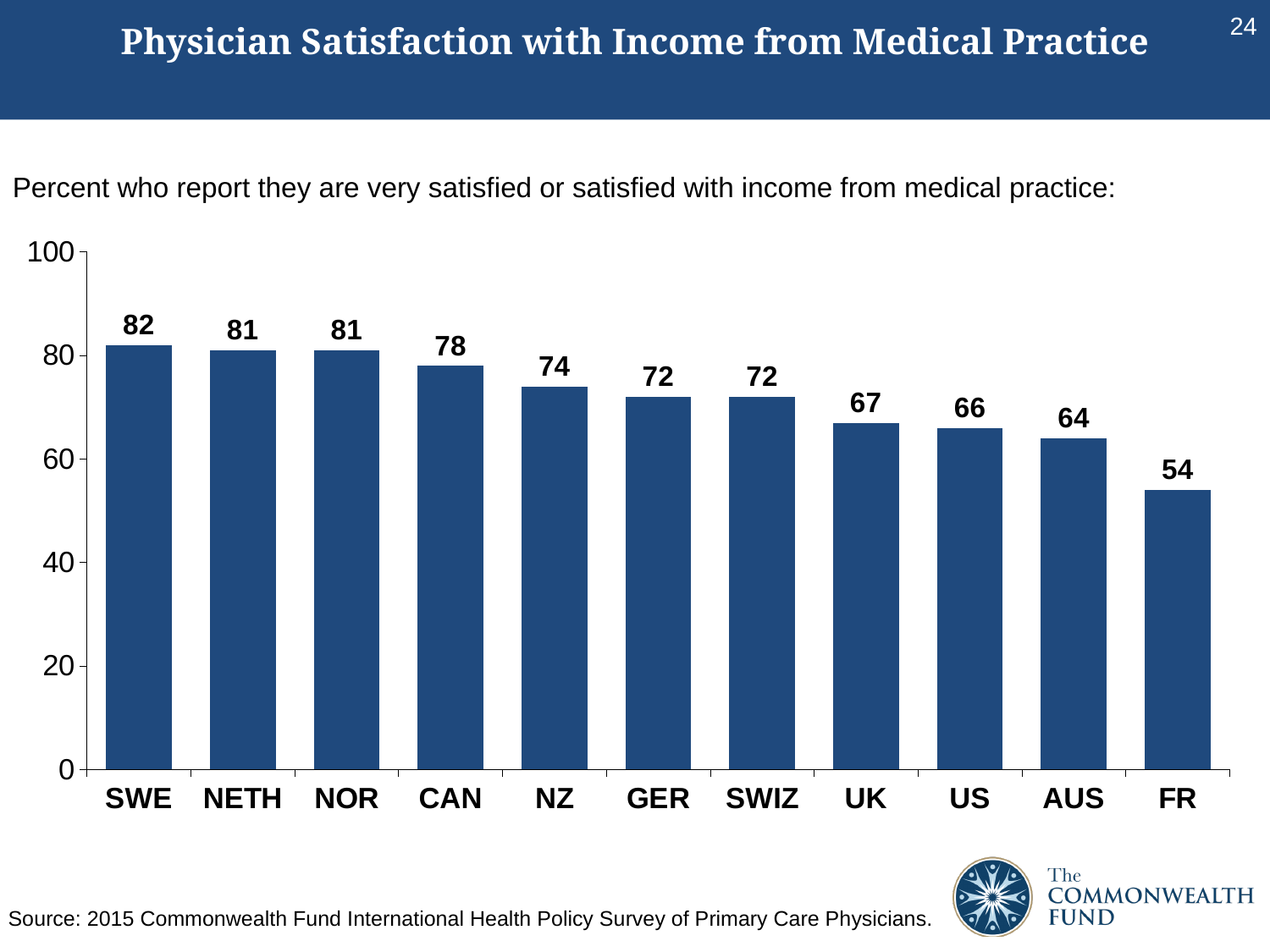
Which is larger, the value for NZ or the value for AUS? NZ What is the value for FR? 54 What kind of chart is shown on the slide? bar chart Is the value for GER greater or less than 60? greater What is the difference between the values for SWE and FR? 28 Which country has the highest value? SWE Do the values rise or fall from left to right along the x axis? fall Which country has the lowest value? FR What is the value for SWE? 82 What is the difference between the values for CAN and UK? 11 How many countries are shown on the chart? 11 What is the value for US? 66